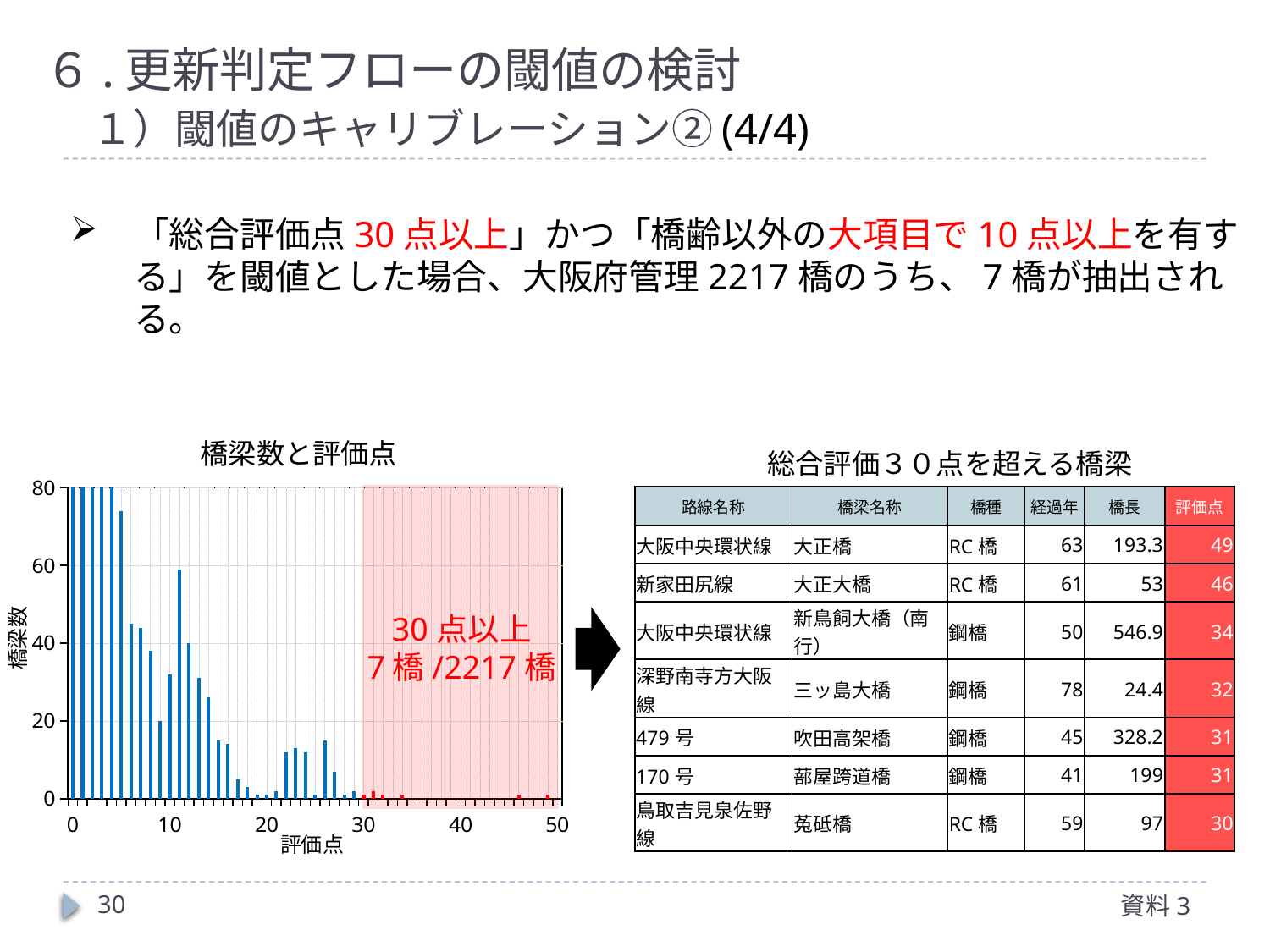
In the chart 橋梁数と評価点, is the value for 評価点 11 greater or less than 40? greater What is the title of the chart on the left of the slide? 橋梁数と評価点 In the chart 橋梁数と評価点, is the value for 評価点 22 greater or less than 20? less What kind of chart is shown under the title 橋梁数と評価点? bar chart In the chart 橋梁数と評価点, do the values rise or fall as 評価点 goes from 11 to 19? fall In the chart 橋梁数と評価点, which has the larger value, 評価点 5 or 評価点 11? 評価点 5 In the chart 橋梁数と評価点, is the value for 評価点 9 greater or less than 40? less In the chart 橋梁数と評価点, which has the larger value, 評価点 11 or 評価点 9? 評価点 11 What is the label of the x axis of the chart 橋梁数と評価点? 評価点